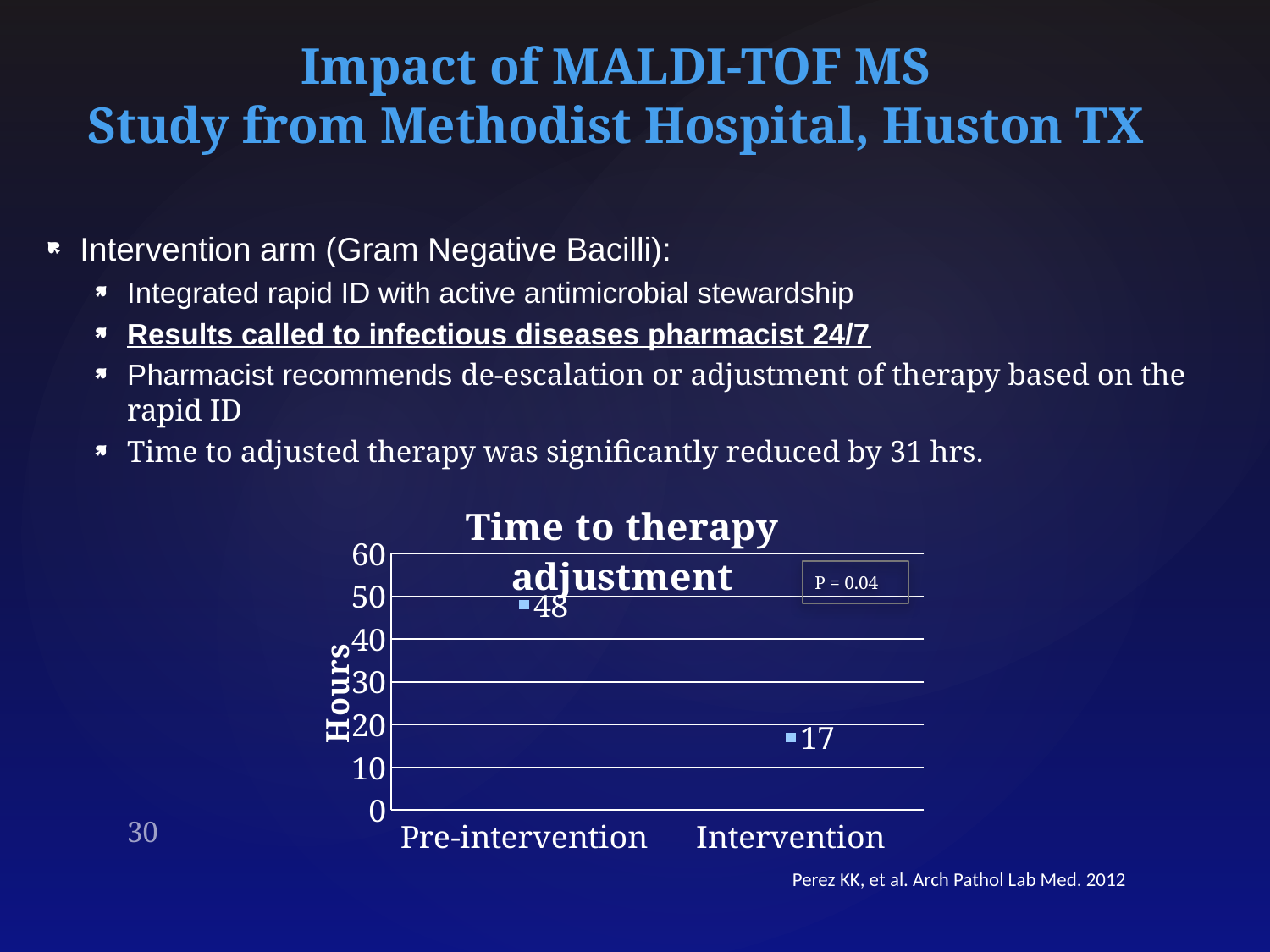
How many categories are shown on the x axis of the Time to therapy adjustment chart? 2 Which category has the highest value in the Time to therapy adjustment chart? Pre-intervention What is the difference between the Pre-intervention and Intervention values in the Time to therapy adjustment chart? 31 What is the value for Pre-intervention in the Time to therapy adjustment chart? 48 What is the label of the y axis in the Time to therapy adjustment chart? Hours What P value is shown in the box on the Time to therapy adjustment chart? P = 0.04 What is the value for Intervention in the Time to therapy adjustment chart? 17 Is the value for Pre-intervention in the Time to therapy adjustment chart greater or less than 40? greater Do the values rise or fall from Pre-intervention to Intervention in the Time to therapy adjustment chart? fall Which is larger in the Time to therapy adjustment chart, the Pre-intervention value or the Intervention value? Pre-intervention Which category has the lowest value in the Time to therapy adjustment chart? Intervention Is the value for Intervention in the Time to therapy adjustment chart greater or less than 20? less